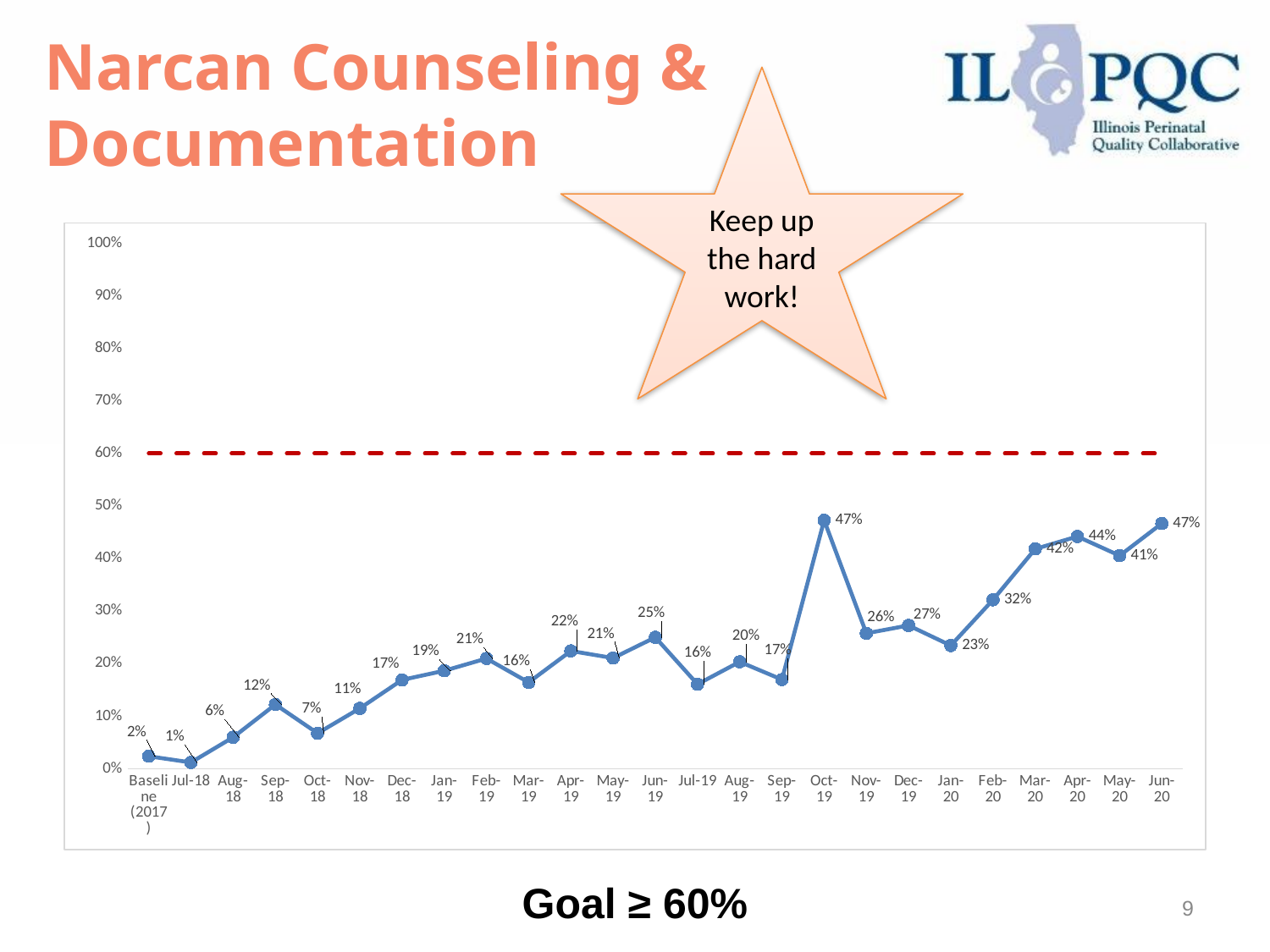
What is the value for Oct-19? 47% What is the value for Sep-18? 12% Which month has the lowest value? Jul-18 Which is larger, the value for Mar-20 or the value for Feb-20? Mar-20 How many data points are plotted on the chart? 25 What is the value for Jan-20? 23% What is the difference between the values for Jun-20 and Jun-19? 22% What is the highest value plotted on the chart? 47% Is the value for Apr-20 greater or less than 60%? less What is the value for the Baseline (2017) point? 2% At what percentage is the red dashed goal line drawn? 60% What kind of chart is shown on the slide? line chart